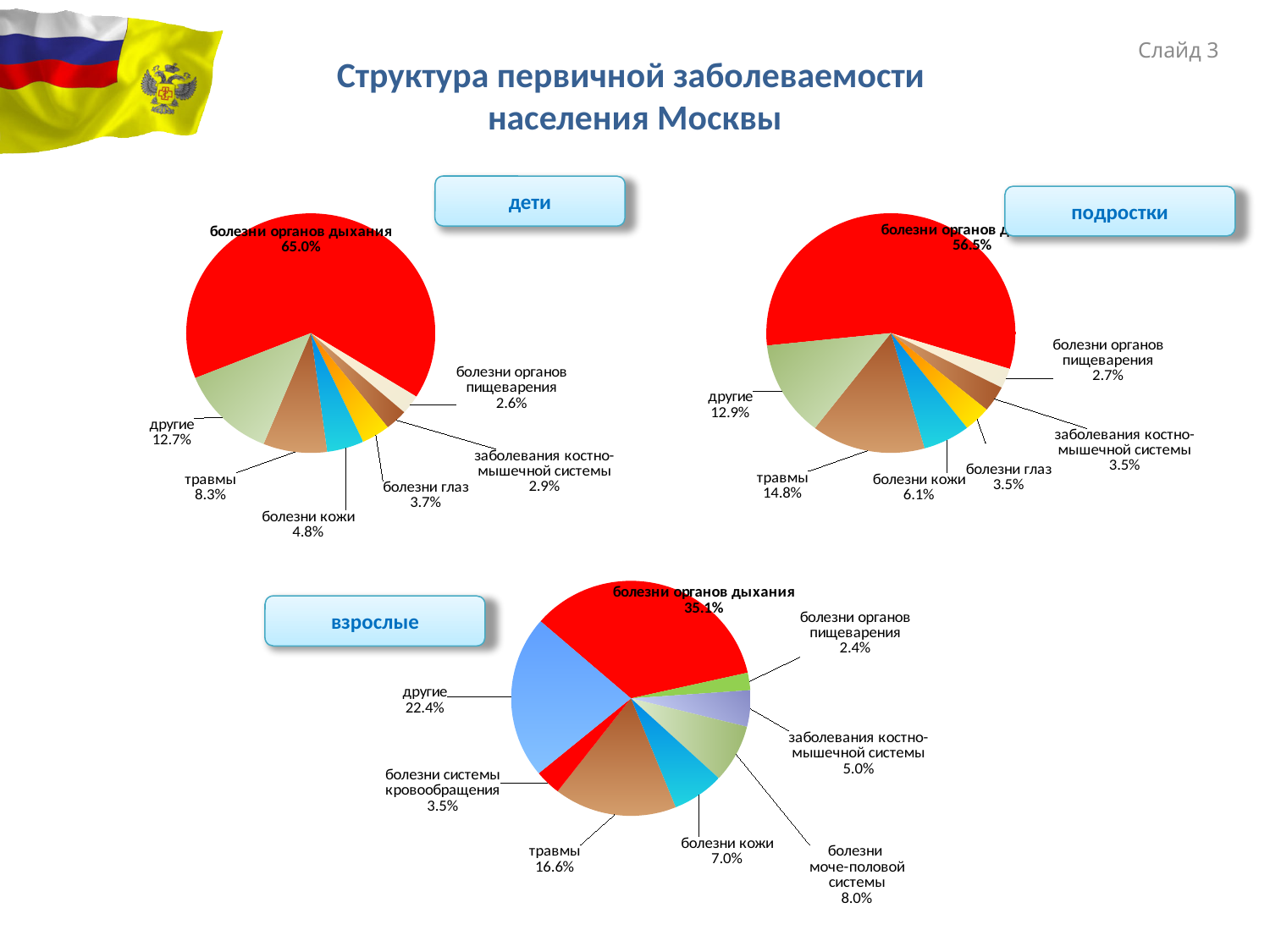
In the "дети" pie chart, what is the difference between the shares for болезни кожи and болезни глаз? 1.1% How many slices does the "дети" pie chart have? 7 In the "взрослые" pie chart, which category has the largest share? болезни органов дыхания In the "взрослые" pie chart, what share is shown for болезни моче-половой системы? 8.0% How many pie charts are shown on the slide? 3 How many slices does the "взрослые" pie chart have? 8 In the "подростки" pie chart, what share is shown for травмы? 14.8% What type of chart is used for the "подростки" data? pie chart In the "дети" pie chart, what share is shown for болезни органов дыхания? 65.0% In the "взрослые" pie chart, which is larger: the share for травмы or the share for другие? другие In the "дети" pie chart, which category has the smallest share? болезни органов пищеварения In the "подростки" pie chart, what is the difference between the shares for травмы and другие? 1.9%